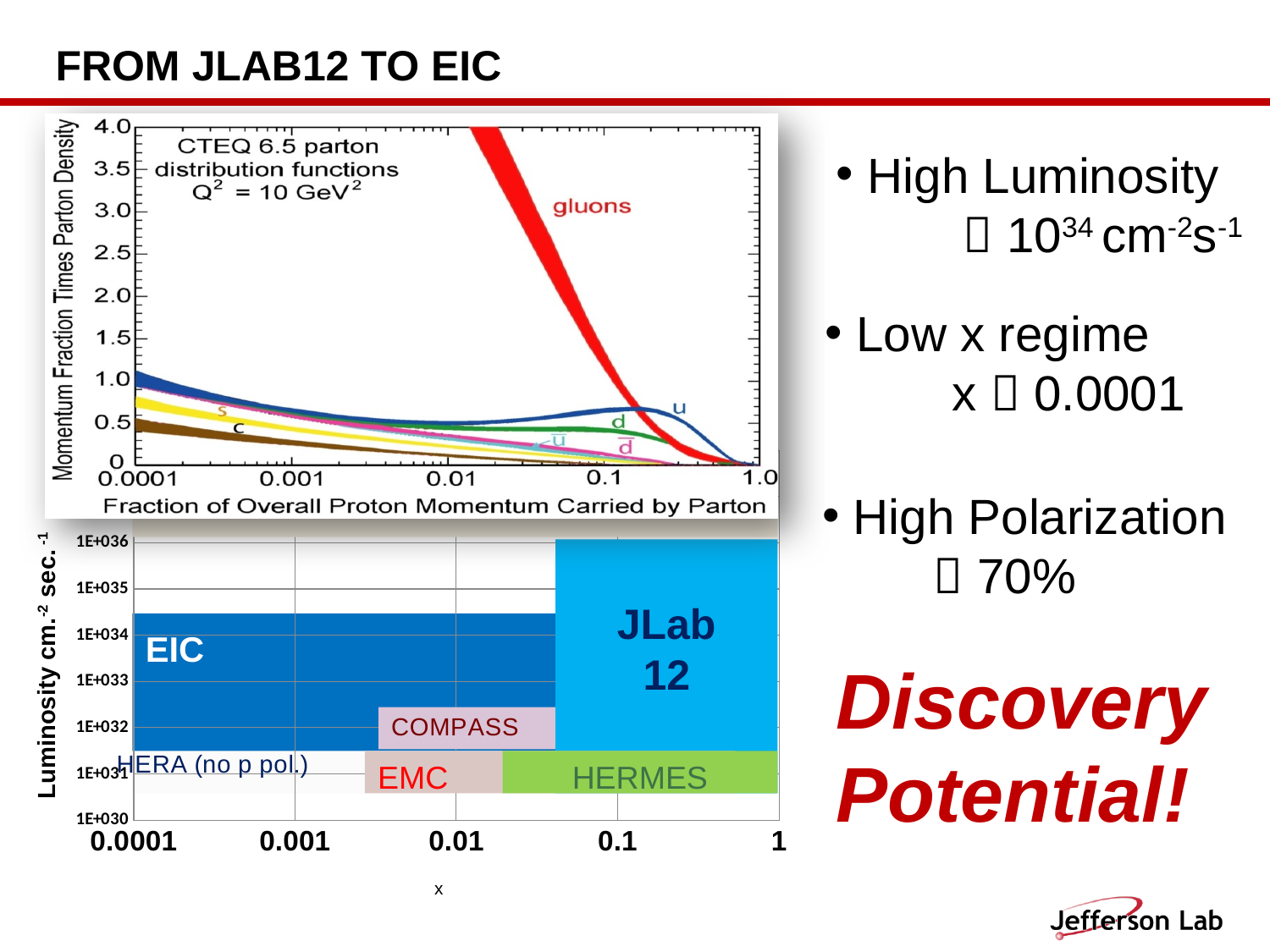
In the top chart, does the gluon curve rise or fall as x increases? fall What kind of chart is the top chart? line chart In the top chart, how many labeled parton curves are shown? 7 In the top chart, what is the title printed in the plot area? CTEQ 6.5 parton distribution functions In the bottom chart, which region reaches a higher luminosity, EIC or COMPASS? EIC In the bottom chart, is the top of the EIC region greater or less than 1E+034? greater In the bottom chart, which labeled experiment region reaches the highest luminosity? JLab 12 In the bottom chart, is the top of the COMPASS region greater or less than 1E+033? less In the top chart, what is the maximum value shown on the y axis? 4.0 In the top chart, what value of Q² is stated? Q² = 10 GeV² In the top chart, which labeled curve reaches the highest values at low x? gluons In the bottom chart, how many labeled experiment regions are shown? 6